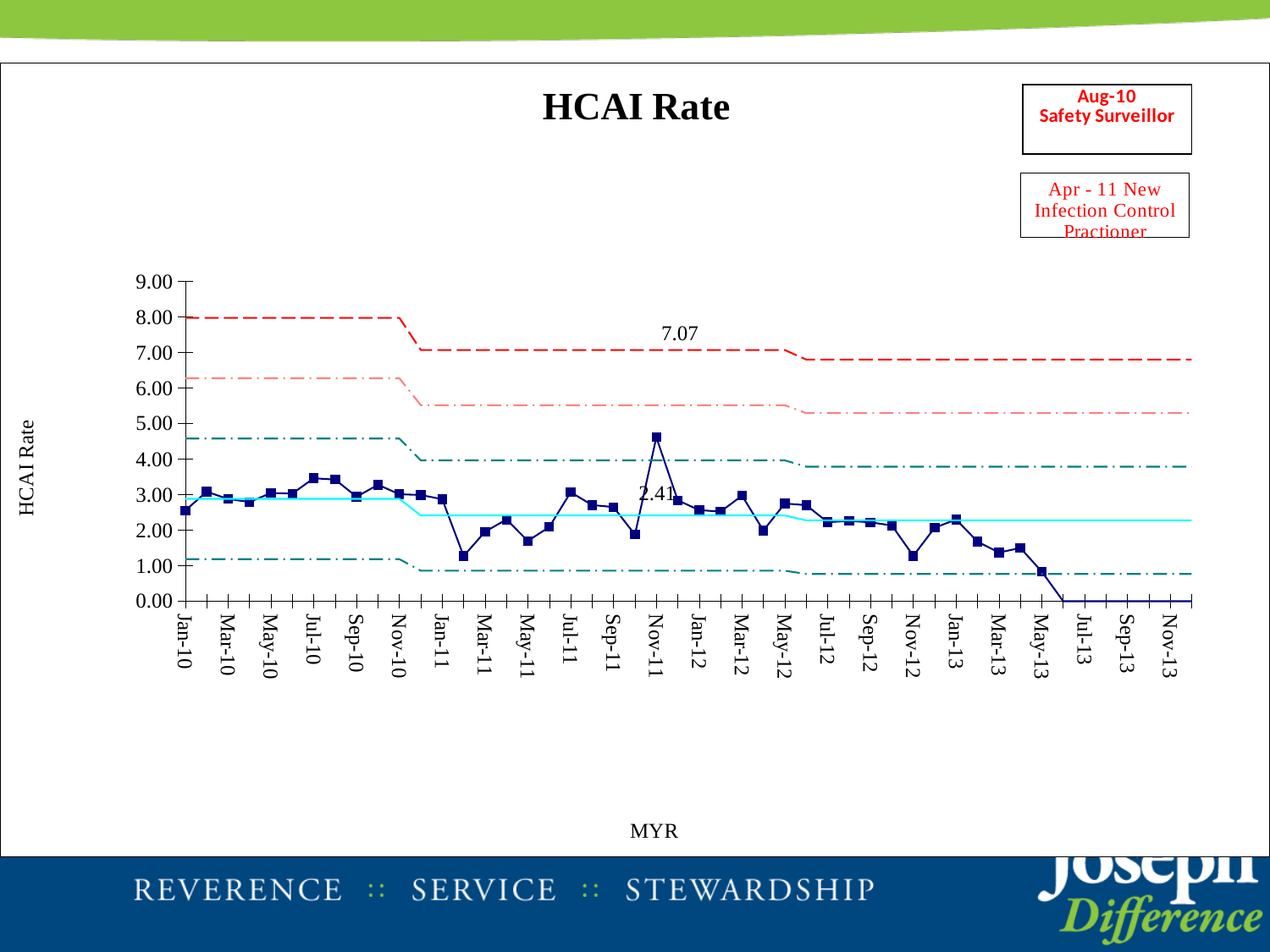
What kind of chart is shown on the slide? line chart What value is printed as a data label on the solid centre line in the middle section of the chart? 2.41 Which has the higher HCAI rate, Nov-11 or Jan-11? Nov-11 What label is shown on the x axis of the chart? MYR Is the HCAI rate for Jan-11 greater or less than 2.00? greater Is the HCAI rate for Nov-12 greater or less than 2.00? less Overall, do the HCAI rate values rise or fall from Jan-10 to Nov-13? fall Is the HCAI rate for Jul-10 greater or less than 3.00? greater What is the title of the chart? HCAI Rate Which month has the highest HCAI rate on the plotted data line? Nov-11 What value is printed as a data label on the upper dashed red line in the middle section of the chart? 7.07